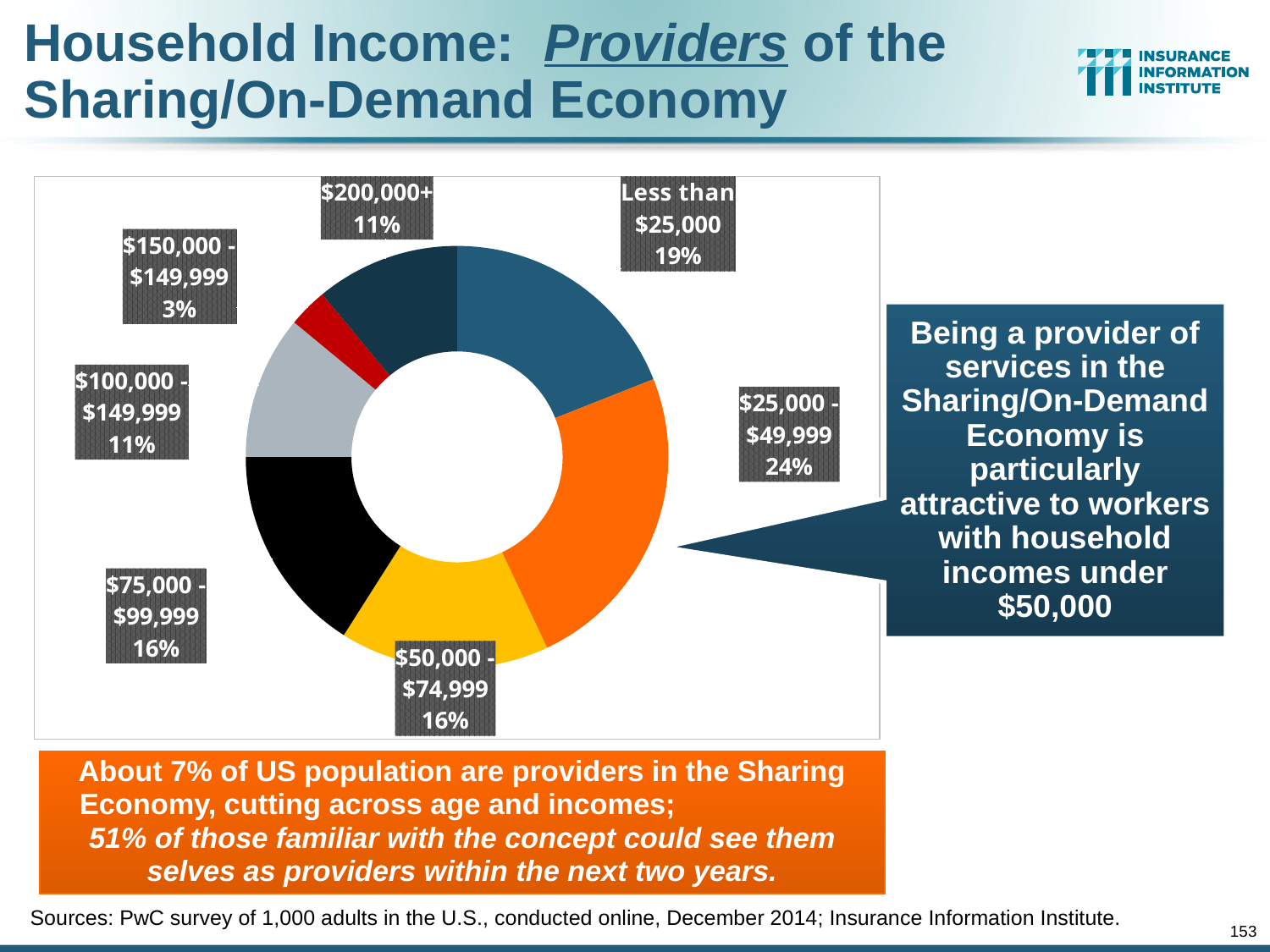
Which is larger: the share for Less than $25,000 or the share for $100,000 - $149,999? Less than $25,000 What colour is the slice for $25,000 - $49,999? Orange Which household income category has the largest share of providers? $25,000 - $49,999 What kind of chart is shown on the slide? Doughnut (pie) chart Which household income category has the smallest share of providers? $150,000 - $149,999 How many household income categories are shown in the chart? 7 What share of providers have a household income of $25,000 - $49,999? 24% What share of providers have a household income of $75,000 - $99,999? 16% What share of providers have a household income of $200,000+? 11% What is the difference in percentage points between the $25,000 - $49,999 share and the Less than $25,000 share? 5 What share of providers have a household income of less than $25,000? 19% What is the combined share of providers with household incomes under $50,000? 43%